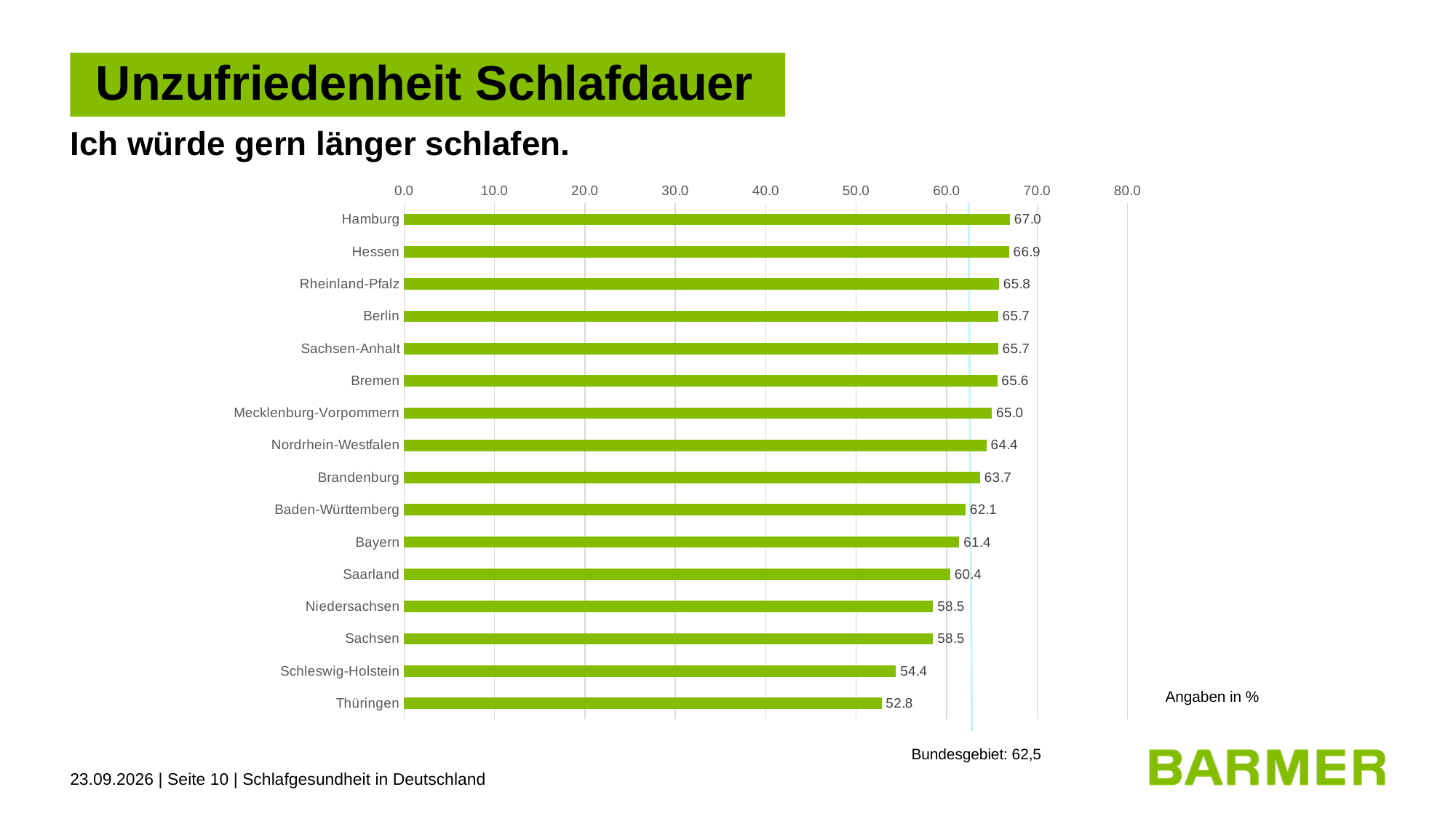
What is the difference between the values for Bayern and Saarland? 1.0 What is the difference between the values for Hamburg and Thüringen? 14.2 What kind of chart is shown on the slide? bar chart What value is given for Bundesgebiet below the chart? 62,5 What is the value for Saarland? 60.4 Is the value for Niedersachsen greater or less than 60.0? less How many federal states are shown in the chart? 16 What is the value for Hamburg? 67.0 Which federal state has the highest value? Hamburg What is the value for Schleswig-Holstein? 54.4 Which federal state has the lowest value? Thüringen Which has a larger value, Brandenburg or Baden-Württemberg? Brandenburg